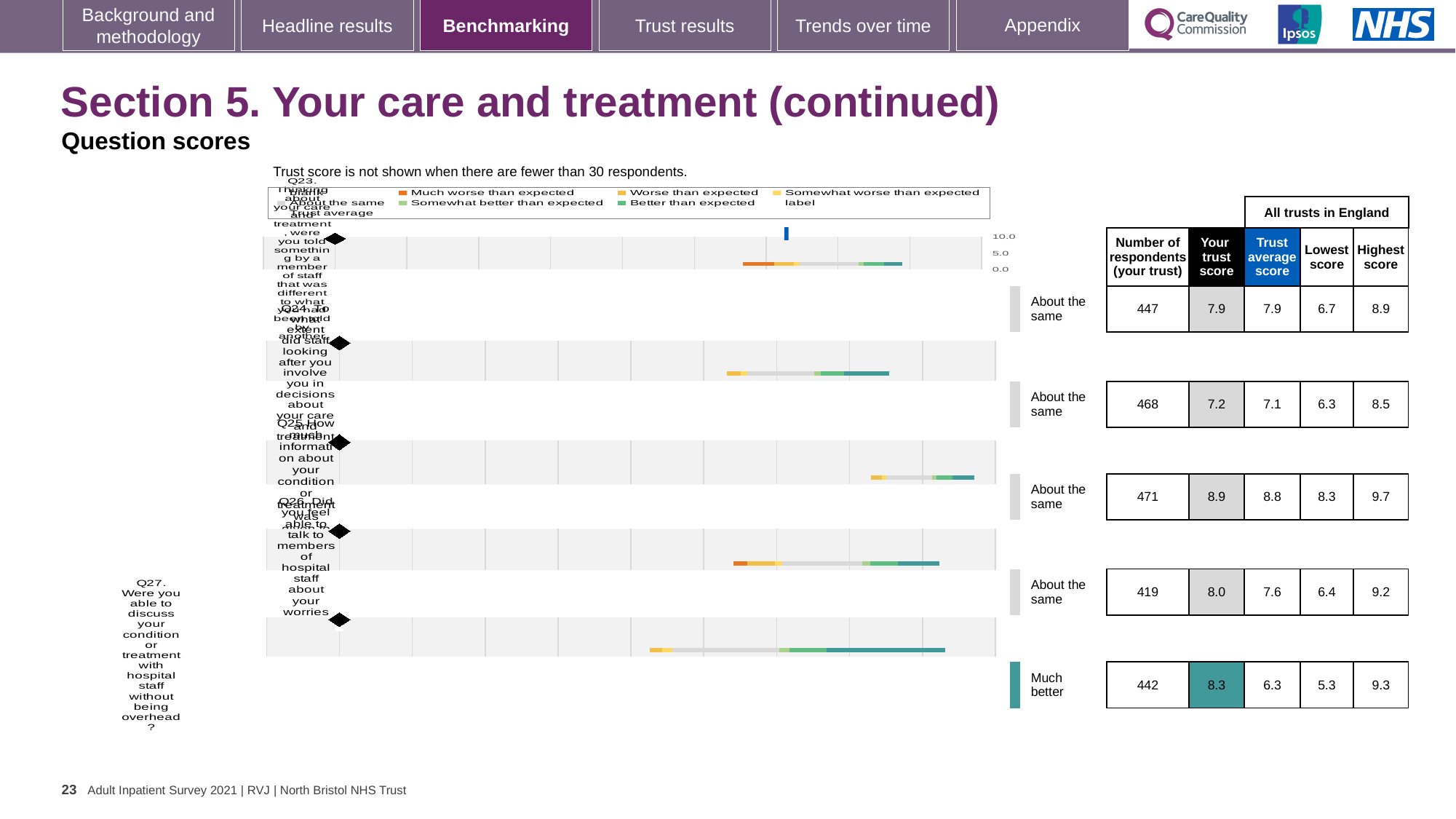
How many questions (Q23 to Q27) are plotted in the benchmarking chart? 5 What is the lowest score across all trusts in England for Q27? 5.3 What kind of chart is used to show the question scores on this slide? bar chart Which question has the highest trust score for this trust? Q25 Which question is rated 'Much better' rather than 'About the same' in the benchmarking chart? Q27 What is the highest score across all trusts in England for Q26 (talking to hospital staff about your worries)? 9.2 How many respondents answered Q25 (information about your condition or treatment)? 471 What is the difference between the trust score and the trust average score for Q27? 2.0 What is the trust score for Q27 (discussing your condition or treatment without being overheard)? 8.3 What is the trust average score for Q24 (staff involving you in decisions about your care and treatment)? 7.1 Which question has the lowest trust score for this trust? Q24 Is the trust score for Q23 larger or smaller than the trust score for Q26? smaller